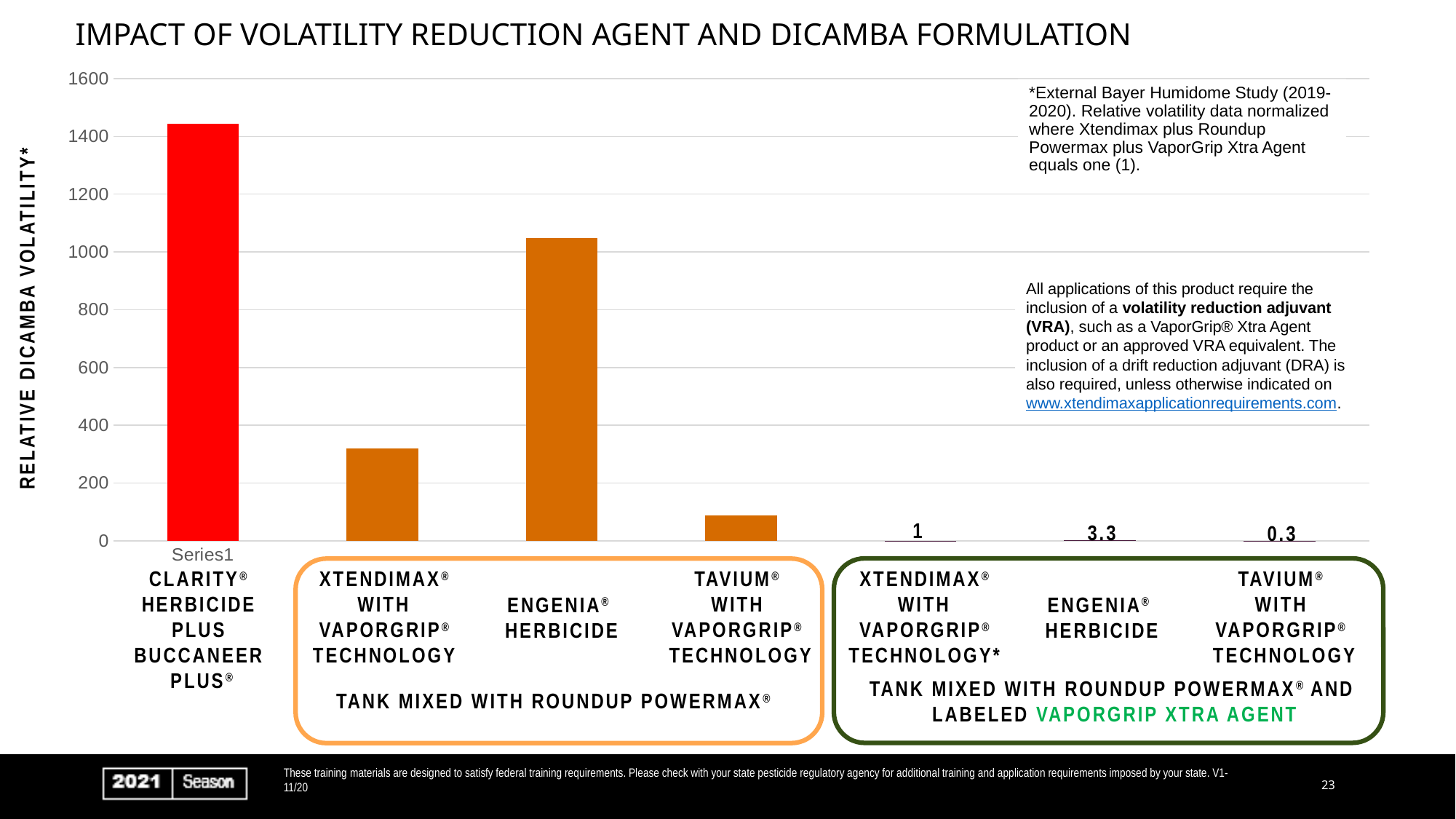
In the group labeled with VaporGrip Xtra Agent, what is the difference between the values for Engenia Herbicide and Tavium with VaporGrip Technology? 3 What is the relative dicamba volatility for Tavium with VaporGrip Technology tank mixed with Roundup Powermax and labeled VaporGrip Xtra Agent? 0.3 Is the value for Tavium with VaporGrip Technology tank mixed with Roundup Powermax (without VaporGrip Xtra Agent) greater or less than 200? less In the group tank mixed with Roundup Powermax only, which has the larger value: Engenia Herbicide or Xtendimax with VaporGrip Technology? Engenia Herbicide Is the value for Clarity Herbicide plus Buccaneer Plus greater or less than 1400? greater Which category has the lowest relative dicamba volatility? Tavium with VaporGrip Technology tank mixed with Roundup Powermax and labeled VaporGrip Xtra Agent What is the relative dicamba volatility for Xtendimax with VaporGrip Technology tank mixed with Roundup Powermax and labeled VaporGrip Xtra Agent? 1 What kind of chart is shown on the slide? bar chart Which category has the highest relative dicamba volatility? Clarity Herbicide plus Buccaneer Plus What is the relative dicamba volatility for Engenia Herbicide tank mixed with Roundup Powermax and labeled VaporGrip Xtra Agent? 3.3 How many bars (categories) are plotted on the chart? 7 Is the value for Engenia Herbicide tank mixed with Roundup Powermax (without VaporGrip Xtra Agent) greater or less than 1000? greater